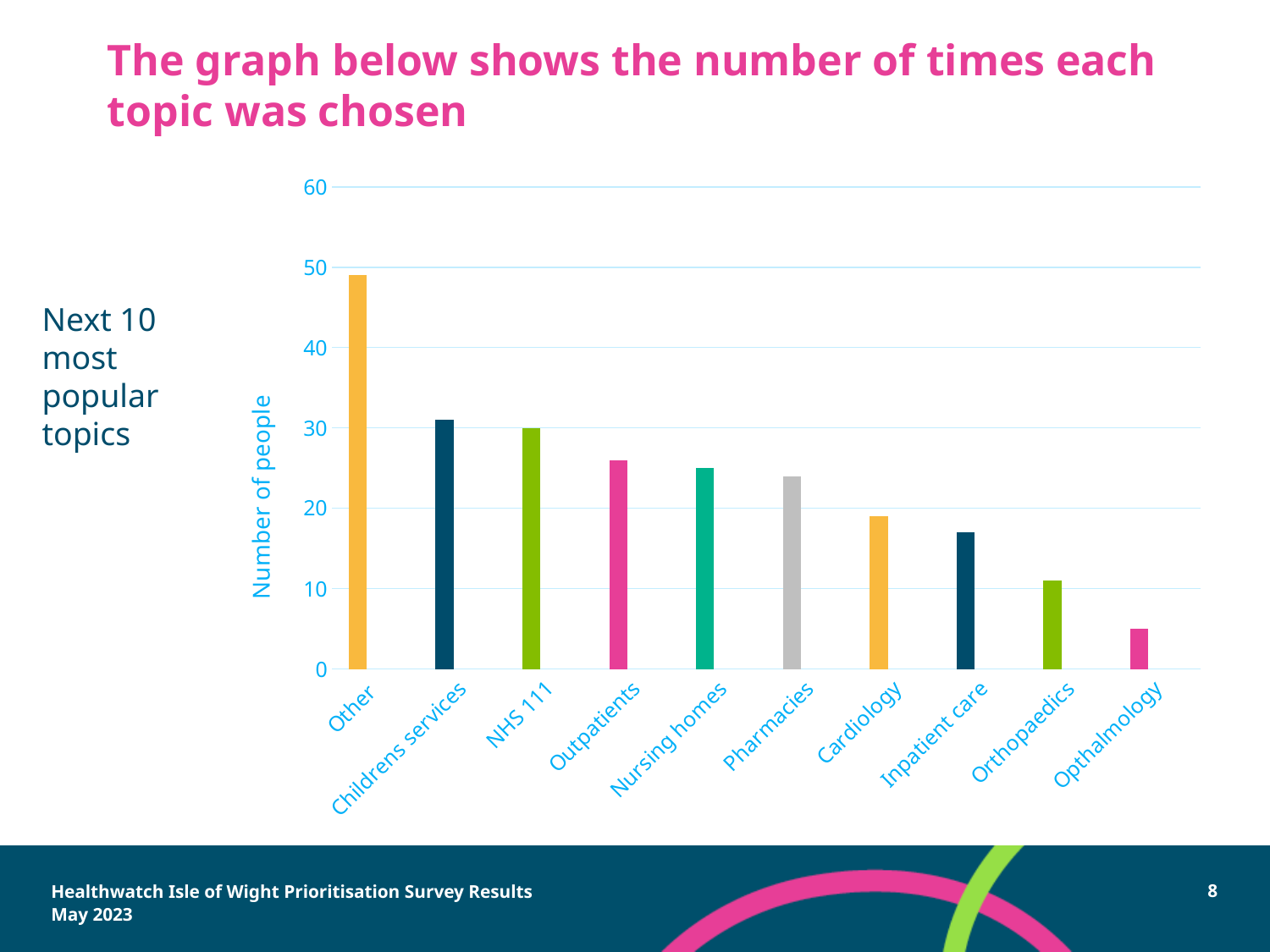
Is the value for Opthalmology greater or less than 10? less How many topics are shown on the x axis of the chart? 10 Is the value for Outpatients greater or less than 20? greater What kind of chart is shown on the slide? bar chart Which has more people, Inpatient care or Pharmacies? Pharmacies Is the value for Other greater or less than 40? greater What is the label on the vertical axis of the chart? Number of people Which has more people, Childrens services or Orthopaedics? Childrens services Which topic has the lowest number of people? Opthalmology Which topic has the highest number of people? Other Do the values rise or fall moving from left to right along the x axis? fall